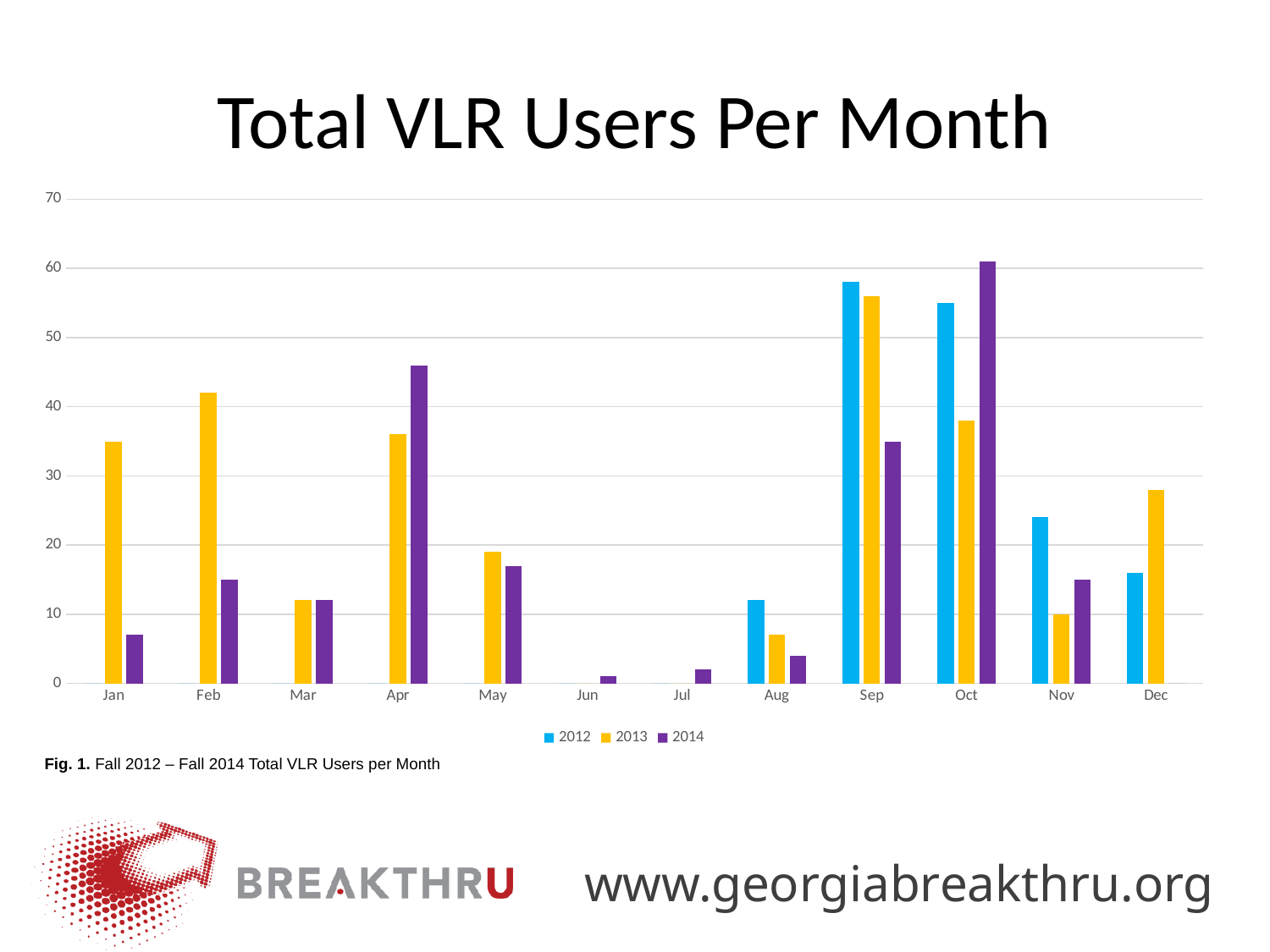
In November, which is larger: the 2012 value or the 2014 value? 2012 Is the 2013 value for Feb greater or less than 30? greater How many series does the legend list? 3 In April, which is larger: the 2013 value or the 2014 value? 2014 In which month is the 2013 value highest? Sep What is the title of the chart? Total VLR Users Per Month What kind of chart is shown on the slide? bar chart In which month is the 2014 value highest? Oct Is the 2012 value for Sep greater or less than 50? greater Do the 2013 values rise or fall from Sep to Nov? fall Is the 2014 value for Jan greater or less than 10? less How many months are shown along the x axis? 12